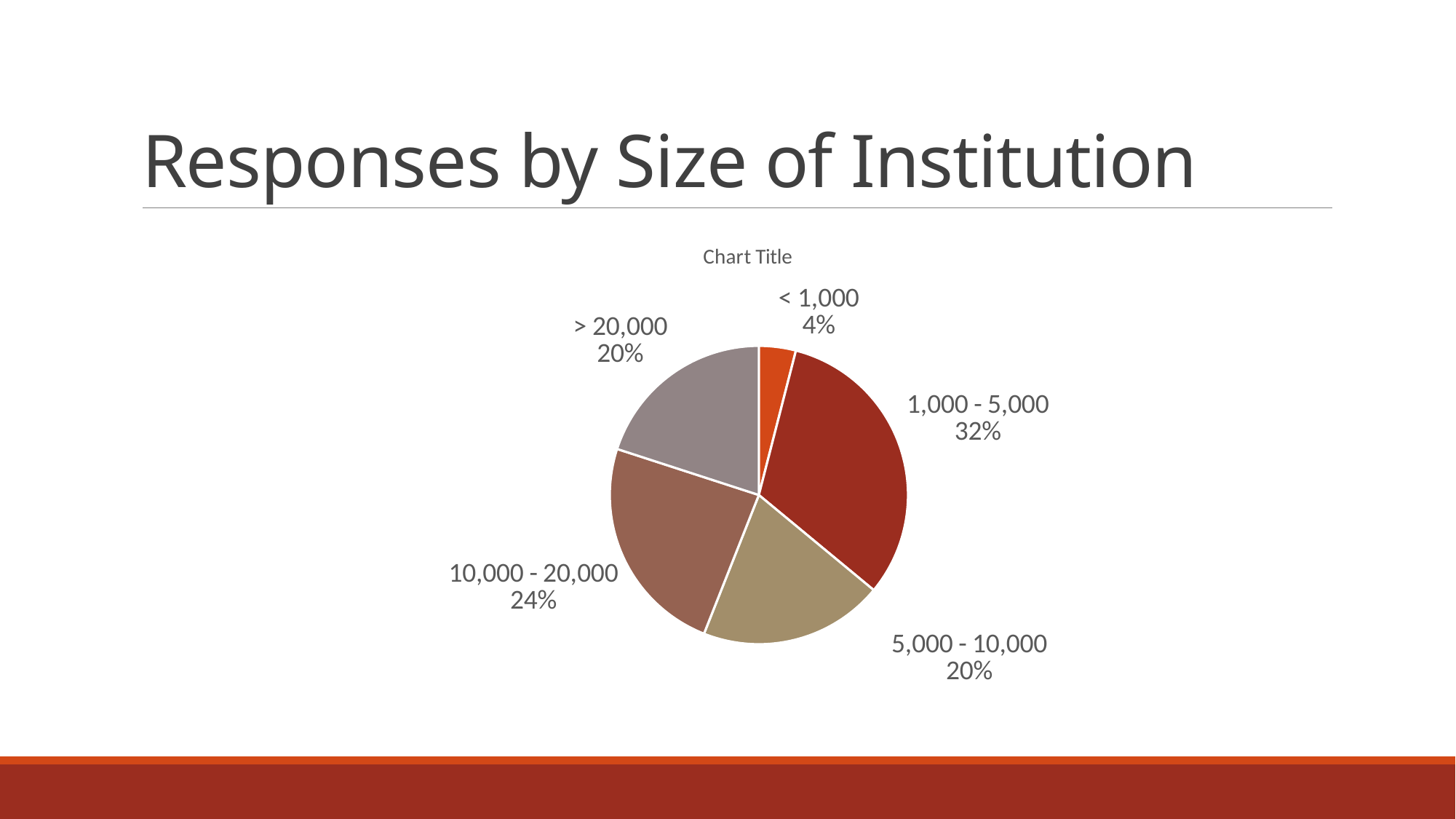
Which slice is larger: 10,000 - 20,000 or 5,000 - 10,000? 10,000 - 20,000 What share of responses comes from institutions with < 1,000? 4% What is the difference in percentage points between the > 20,000 slice and the < 1,000 slice? 16 What share of responses comes from institutions with 10,000 - 20,000? 24% How many slices does the pie chart have? 5 What is the title printed above the pie chart? Chart Title What kind of chart is shown on the slide? pie chart What share of responses comes from institutions with > 20,000? 20% Which institution size category has the largest share of responses? 1,000 - 5,000 Which institution size category has the smallest share of responses? < 1,000 What is the difference in percentage points between the 1,000 - 5,000 slice and the 10,000 - 20,000 slice? 8